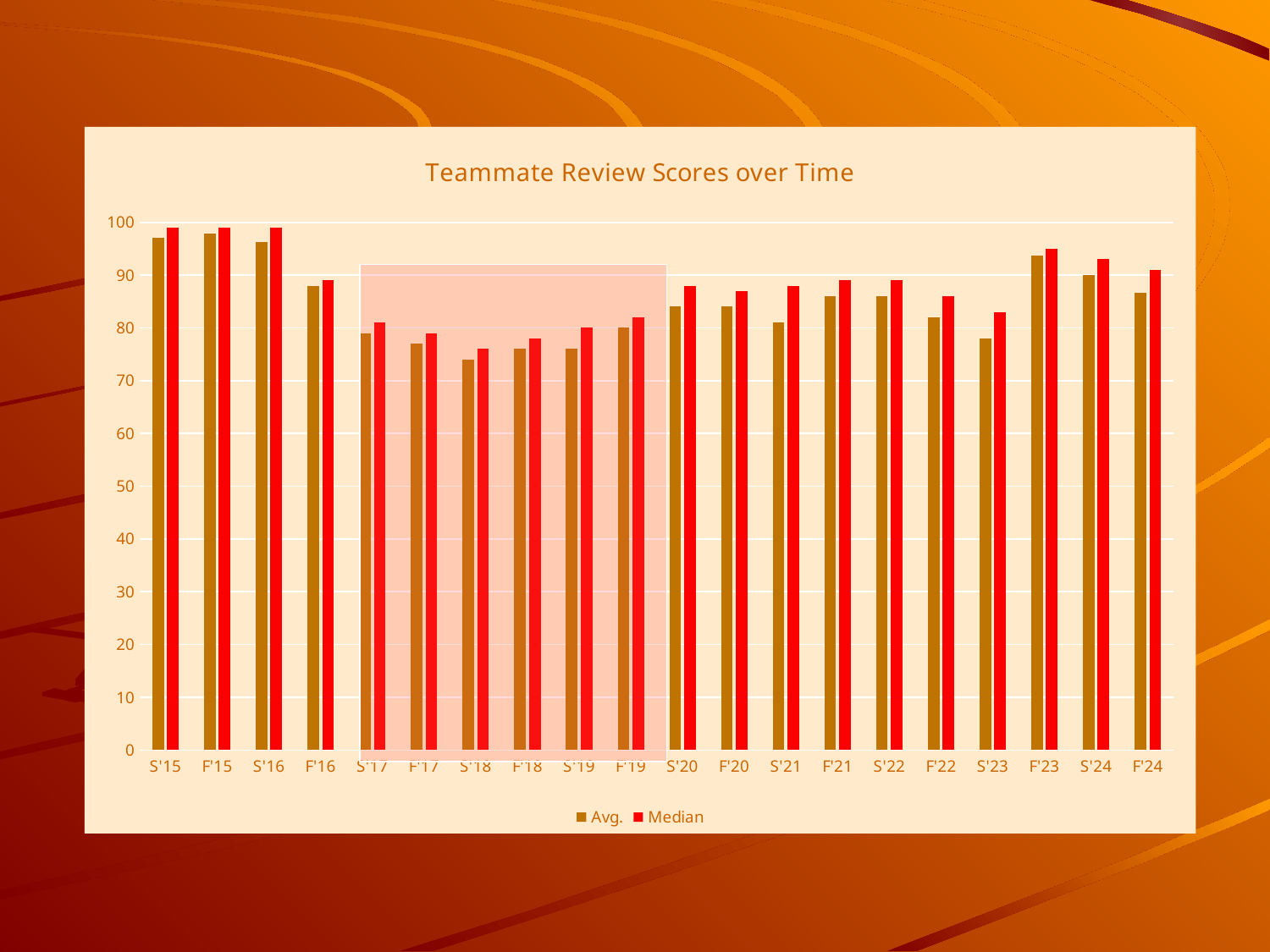
Which is larger, the Avg. value for S'15 or the Avg. value for S'18? S'15 Is the Avg. value for F'17 greater or less than 80? less What kind of chart is shown on the slide? bar chart Is the Median value for F'23 greater or less than 90? greater Is the Median value for S'15 greater or less than 90? greater Which is larger, the Median value for F'23 or the Median value for S'23? F'23 Which series is drawn in red according to the legend? Median How many semester categories are shown on the x axis? 20 How many series does the legend list? 2 What is the title of the chart? Teammate Review Scores over Time Do the Avg. values rise or fall from S'15 to S'18? fall